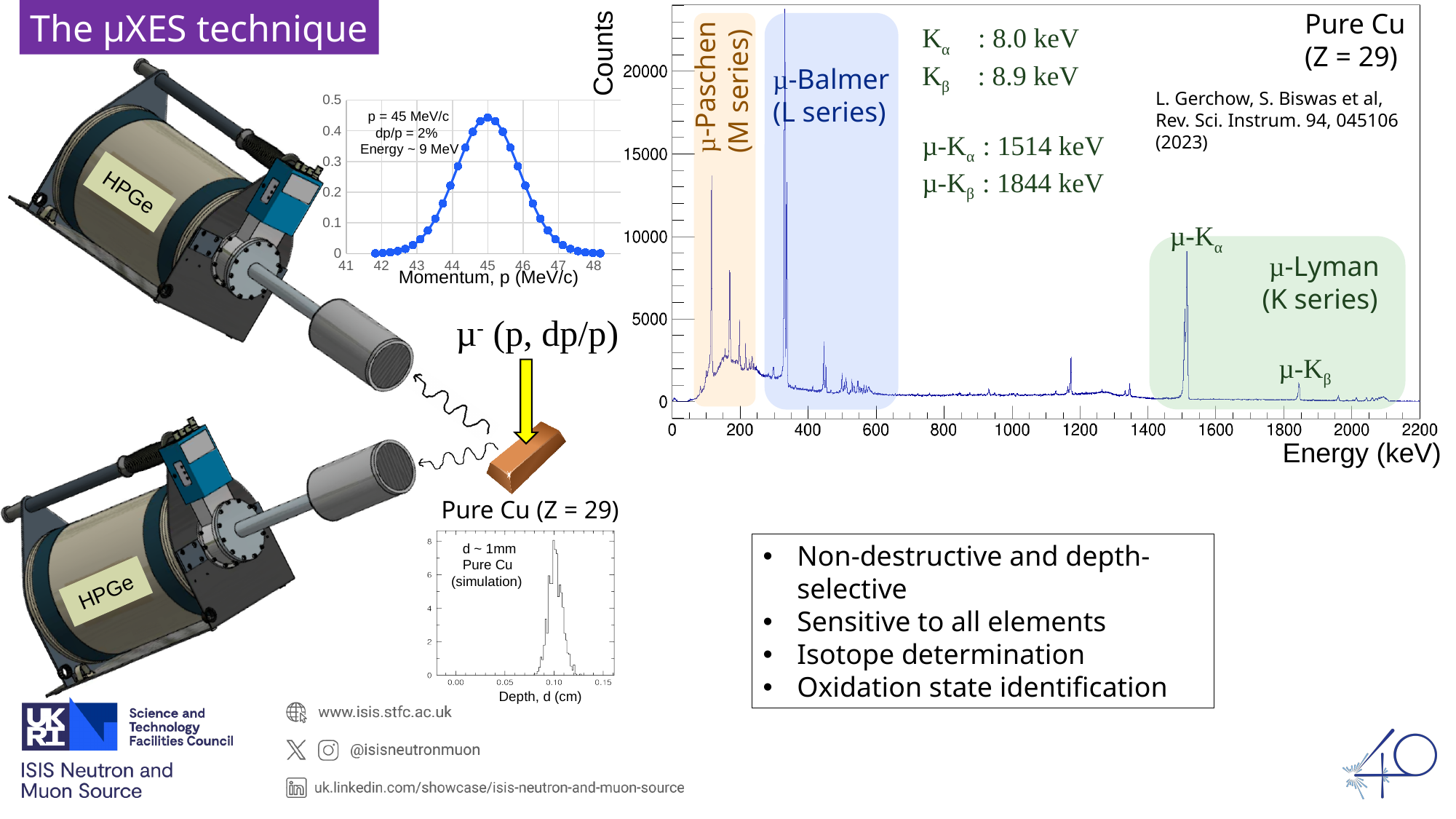
In the energy spectrum chart on the right, which peak is higher: the μ-Kα peak or the μ-Kβ peak? μ-Kα In the energy spectrum chart on the right, what is the difference between the μ-Kβ and μ-Kα energies? 330 keV In the energy spectrum chart on the right, what is the label of the x axis? Energy (keV) In the depth chart at the bottom middle of the slide, what is the label of the x axis? Depth, d (cm) In the energy spectrum chart on the right, what energy is given for the μ-Kα line? 1514 keV In the energy spectrum chart on the right, is the count at the μ-Kα peak near 1514 keV greater or less than 10000? less In the momentum chart in the upper middle of the slide, is the peak value greater or less than 0.4? greater In the momentum chart in the upper middle of the slide, at what momentum does the distribution peak? 45 MeV/c In the energy spectrum chart on the right, what energy is given for the μ-Kβ line? 1844 keV In the energy spectrum chart on the right, what is the label of the y axis? Counts In the energy spectrum chart on the right, is the tallest peak in the μ-Balmer (L series) region greater or less than 20000 counts? greater In the energy spectrum chart on the right, which series is the shaded region labelled μ-Lyman associated with? K series